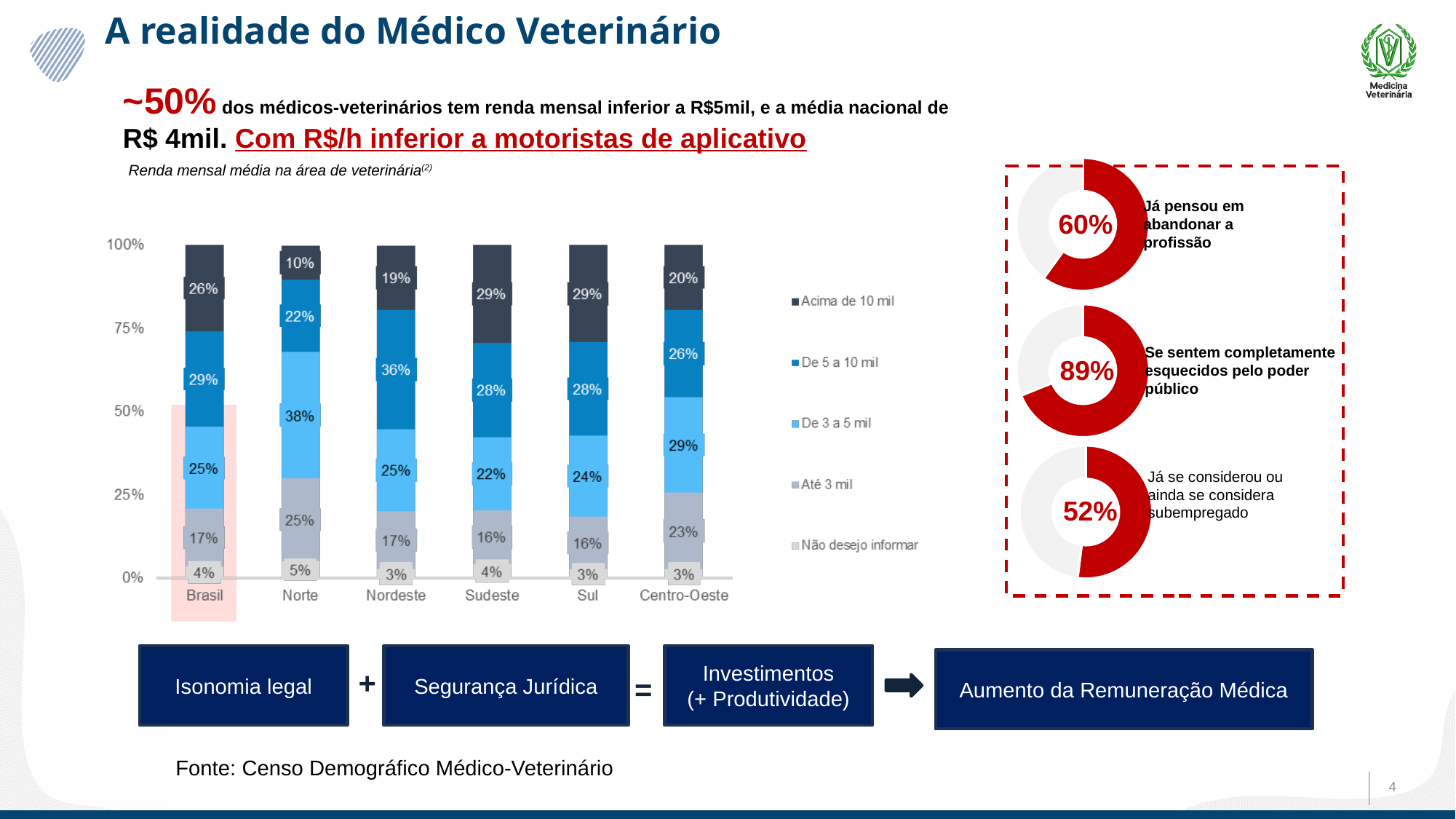
In the stacked bar chart 'Renda mensal média na área de veterinária', what is the difference between the 'De 3 a 5 mil' values for Norte and Sudeste? 16% In the stacked bar chart 'Renda mensal média na área de veterinária', which region has the highest value for 'De 5 a 10 mil'? Nordeste In the stacked bar chart 'Renda mensal média na área de veterinária', what is the value of 'De 3 a 5 mil' for Norte? 38% In the stacked bar chart 'Renda mensal média na área de veterinária', which is larger: 'Até 3 mil' for Norte or 'Até 3 mil' for Sul? Norte How many regions (categories) are shown on the x axis of the stacked bar chart 'Renda mensal média na área de veterinária'? 6 In the stacked bar chart 'Renda mensal média na área de veterinária', which region has the lowest value for 'Acima de 10 mil'? Norte How many series does the legend of the stacked bar chart 'Renda mensal média na área de veterinária' list? 5 What kind of chart is 'Renda mensal média na área de veterinária'? Stacked bar chart In the stacked bar chart 'Renda mensal média na área de veterinária', what is the value of 'Acima de 10 mil' for Brasil? 26% In the donut chart labelled 'Já pensou em abandonar a profissão', what percentage is shown? 60% In the stacked bar chart 'Renda mensal média na área de veterinária', what is the value of 'Até 3 mil' for Centro-Oeste? 23% In the donut chart labelled 'Se sentem completamente esquecidos pelo poder público', what percentage is shown? 89%